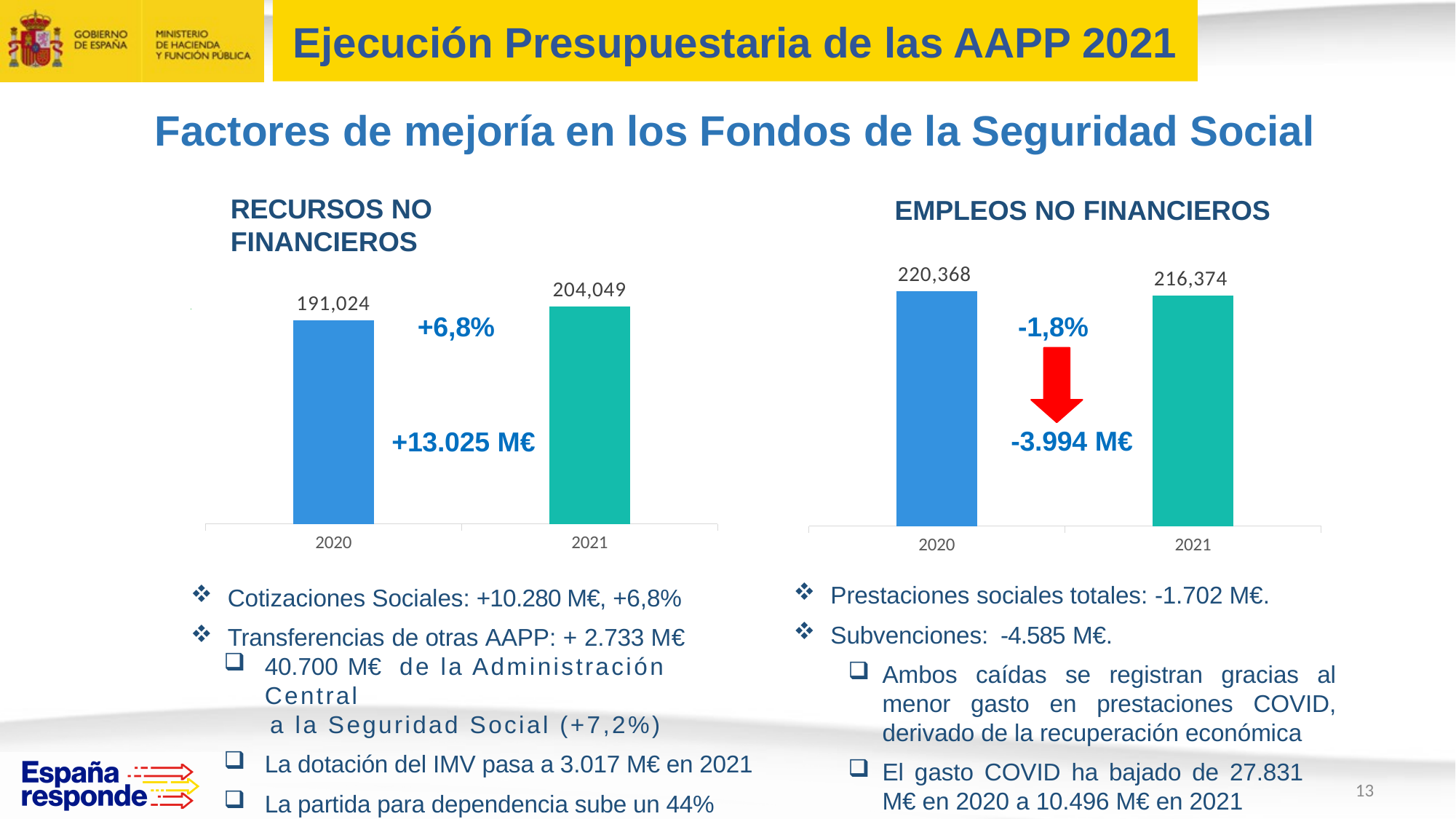
What type of chart is the EMPLEOS NO FINANCIEROS chart? bar chart In the EMPLEOS NO FINANCIEROS chart, do the values rise or fall from 2020 to 2021? fall In the EMPLEOS NO FINANCIEROS chart, what is the value for 2020? 220,368 In the RECURSOS NO FINANCIEROS chart, which year has the higher value? 2021 In the RECURSOS NO FINANCIEROS chart, what is the value for 2020? 191,024 In the RECURSOS NO FINANCIEROS chart, what is the value for 2021? 204,049 How many bars are shown in the RECURSOS NO FINANCIEROS chart? 2 In the RECURSOS NO FINANCIEROS chart, what is the difference between the 2021 and 2020 values? 13,025 In the EMPLEOS NO FINANCIEROS chart, which year has the lower value? 2021 In the EMPLEOS NO FINANCIEROS chart, is the value for 2020 larger or smaller than the value for 2021? larger In the EMPLEOS NO FINANCIEROS chart, what is the difference between the 2020 and 2021 values? 3,994 In the EMPLEOS NO FINANCIEROS chart, what is the value for 2021? 216,374